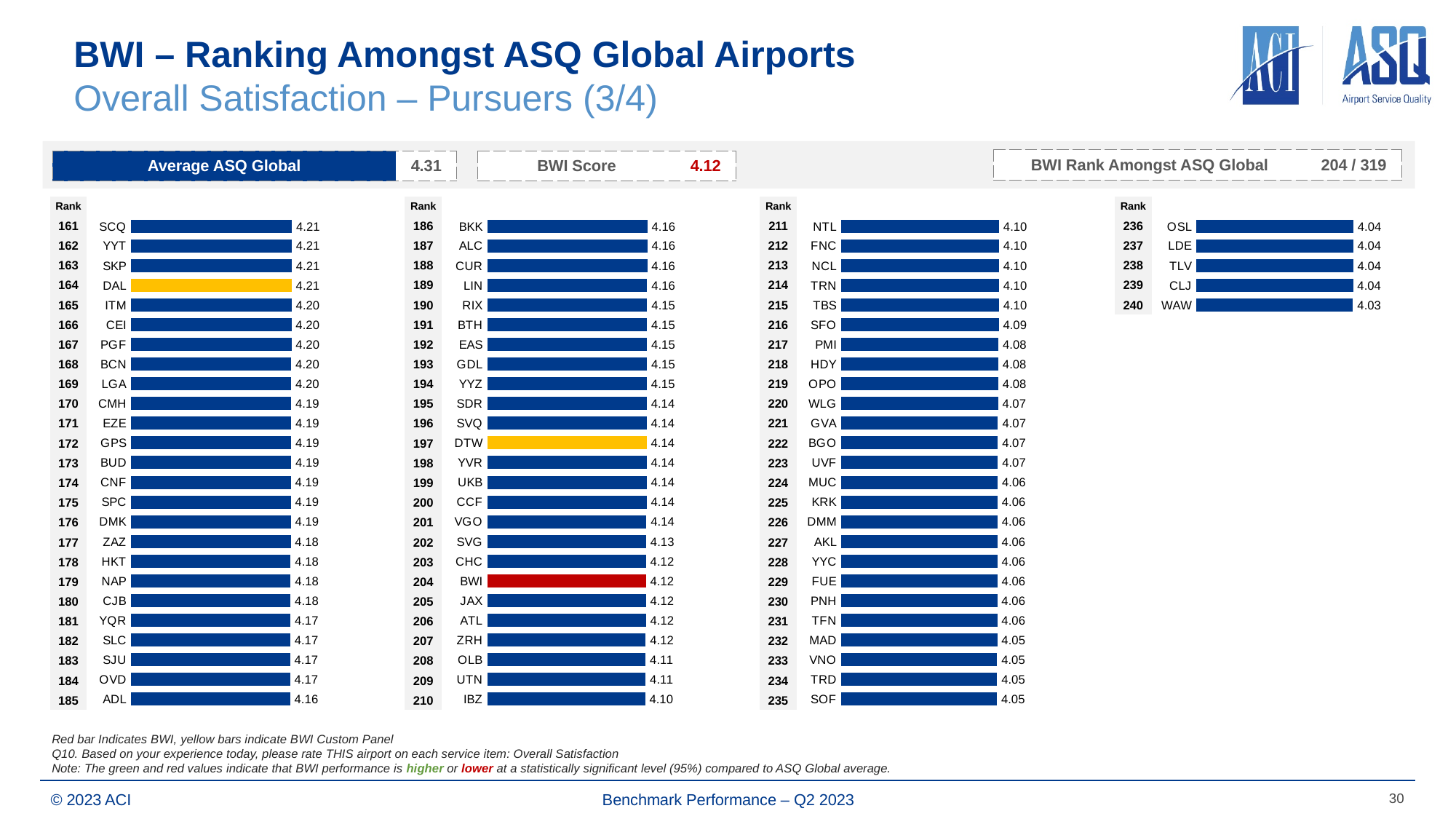
In the fourth panel (ranks 236–240), which airport has the lowest value? WAW In the first panel (ranks 161–185), what is the difference between the values for SCQ and ADL? 0.05 What kind of chart is used to show the airport scores on this slide? Bar chart In the second panel (ranks 186–210), what is the value shown for BWI? 4.12 In the third panel (ranks 211–235), what is the value shown for SFO? 4.09 In the fourth panel (ranks 236–240), what is the value shown for WAW? 4.03 In the first panel (ranks 161–185), what is the value shown for SCQ? 4.21 What is the difference between the Average ASQ Global score and the BWI Score? 0.19 In the second panel (ranks 186–210), which has the higher value, DTW or BWI? DTW How many airports are listed in the fourth panel (ranks 236–240)? 5 What is the Average ASQ Global score shown at the top of the slide? 4.31 What is BWI's rank amongst ASQ Global airports as shown on the slide? 204 / 319